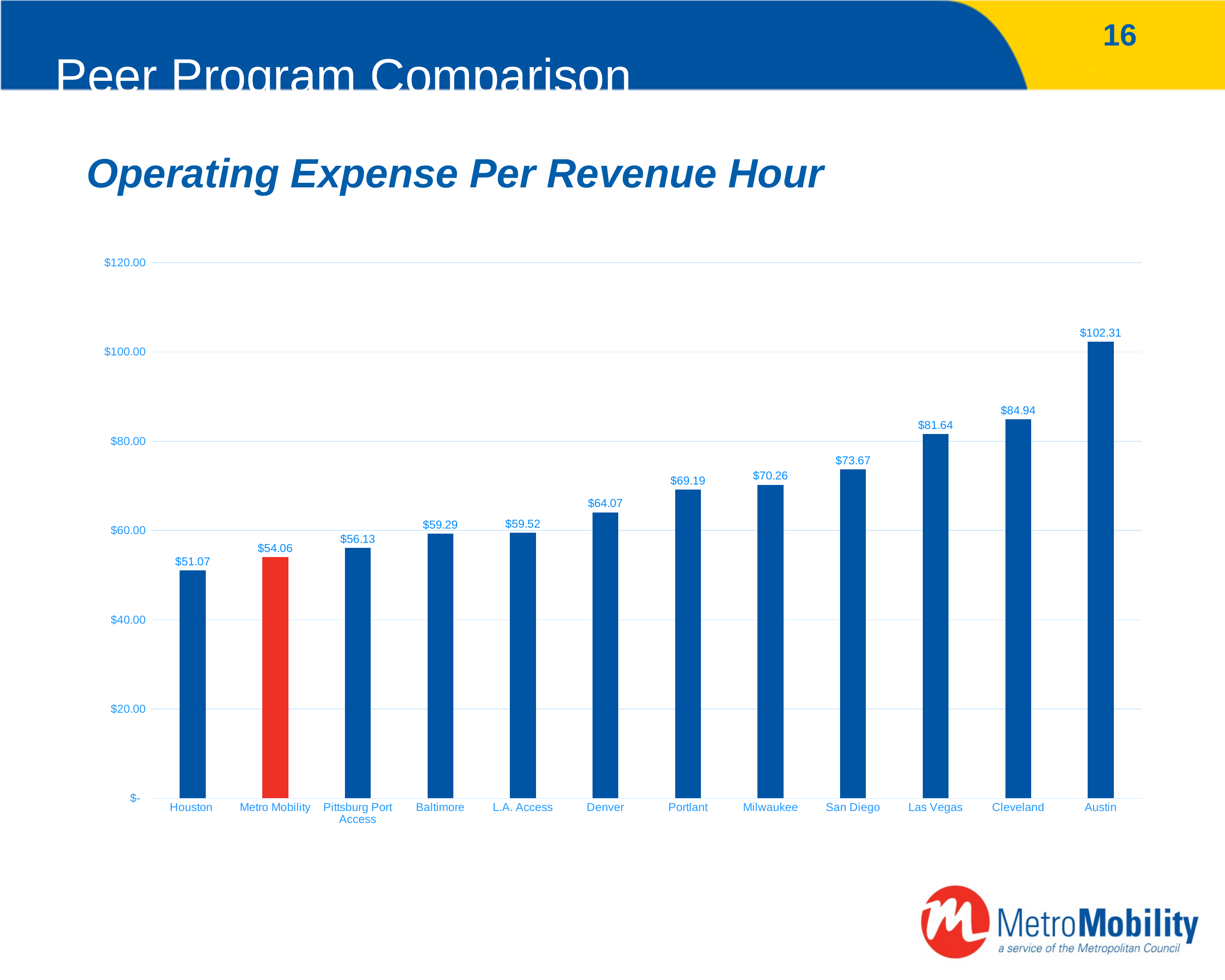
What type of chart is shown on the slide? Bar chart Which program has the lowest operating expense per revenue hour? Houston What is the value shown for Denver? $64.07 What is the operating expense per revenue hour for Austin? $102.31 Which program has the highest operating expense per revenue hour? Austin How many programs are shown on the chart? 12 How much higher is Cleveland's value than Las Vegas's value? $3.30 Is the value for San Diego greater or less than $80.00? less What is the operating expense per revenue hour for Metro Mobility? $54.06 Which has a higher operating expense per revenue hour, Milwaukee or Denver? Milwaukee What is the difference between Austin's and Houston's operating expense per revenue hour? $51.24 Do the values rise or fall from left to right across the chart? Rise